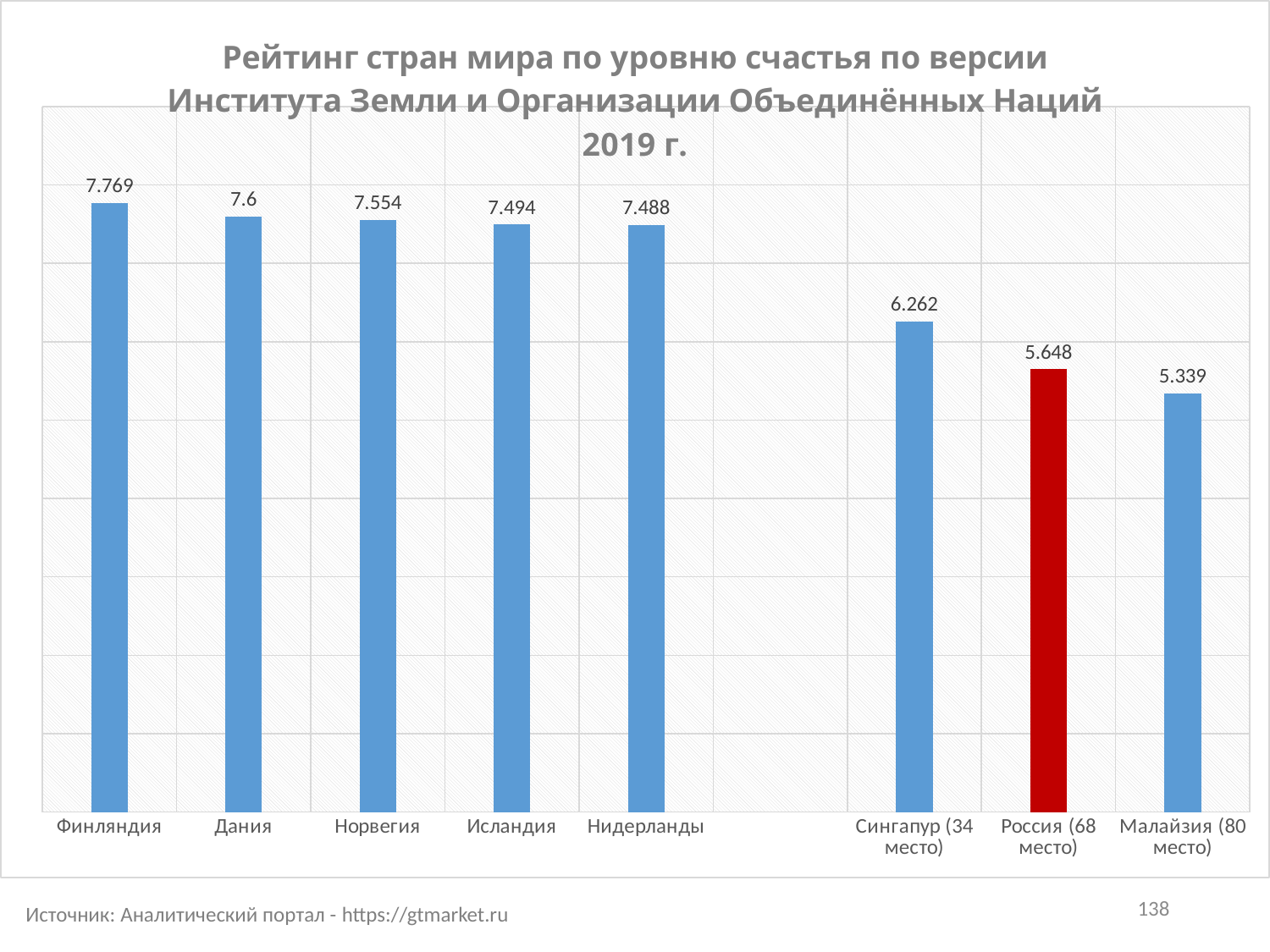
Which country has the lowest value on the chart? Малайзия (80 место) Which has a larger value, Дания or Норвегия? Дания What value is shown for Нидерланды? 7.488 What is the happiness score shown for Финляндия? 7.769 What type of chart is shown on the slide? Bar chart Which country has the highest value on the chart? Финляндия Which country's bar is coloured red instead of blue? Россия (68 место) How many countries have bars on the chart? 8 What value is shown for Сингапур (34 место)? 6.262 What is the difference between the values for Финляндия and Россия (68 место)? 2.121 What is the difference between the values for Сингапур (34 место) and Малайзия (80 место)? 0.923 What value is shown for Россия (68 место)? 5.648